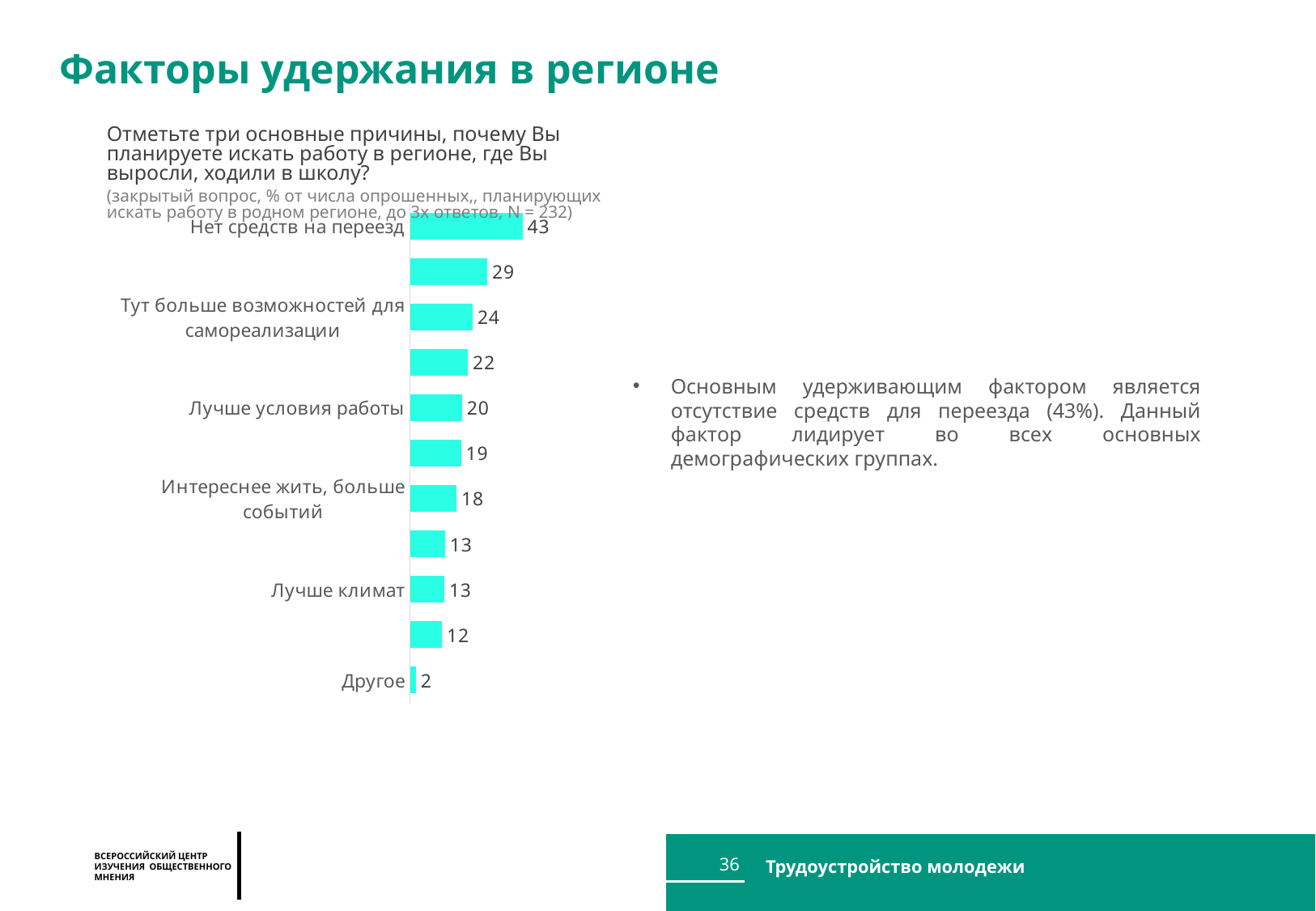
What value is shown for "Лучше климат"? 13 What value is shown for "Интереснее жить, больше событий"? 18 What value is shown for "Лучше условия работы"? 20 How many bars are plotted in the chart? 11 What value is shown for "Нет средств на переезд"? 43 What is the difference between the values for "Нет средств на переезд" and "Лучше условия работы"? 23 Which category has the lowest value in the chart? Другое Which category has the highest value in the chart? Нет средств на переезд Which is larger: the value for "Тут больше возможностей для самореализации" or the value for "Лучше климат"? Тут больше возможностей для самореализации What value is shown for "Тут больше возможностей для самореализации"? 24 What type of chart is shown on the slide? Bar chart What value is shown for "Другое"? 2